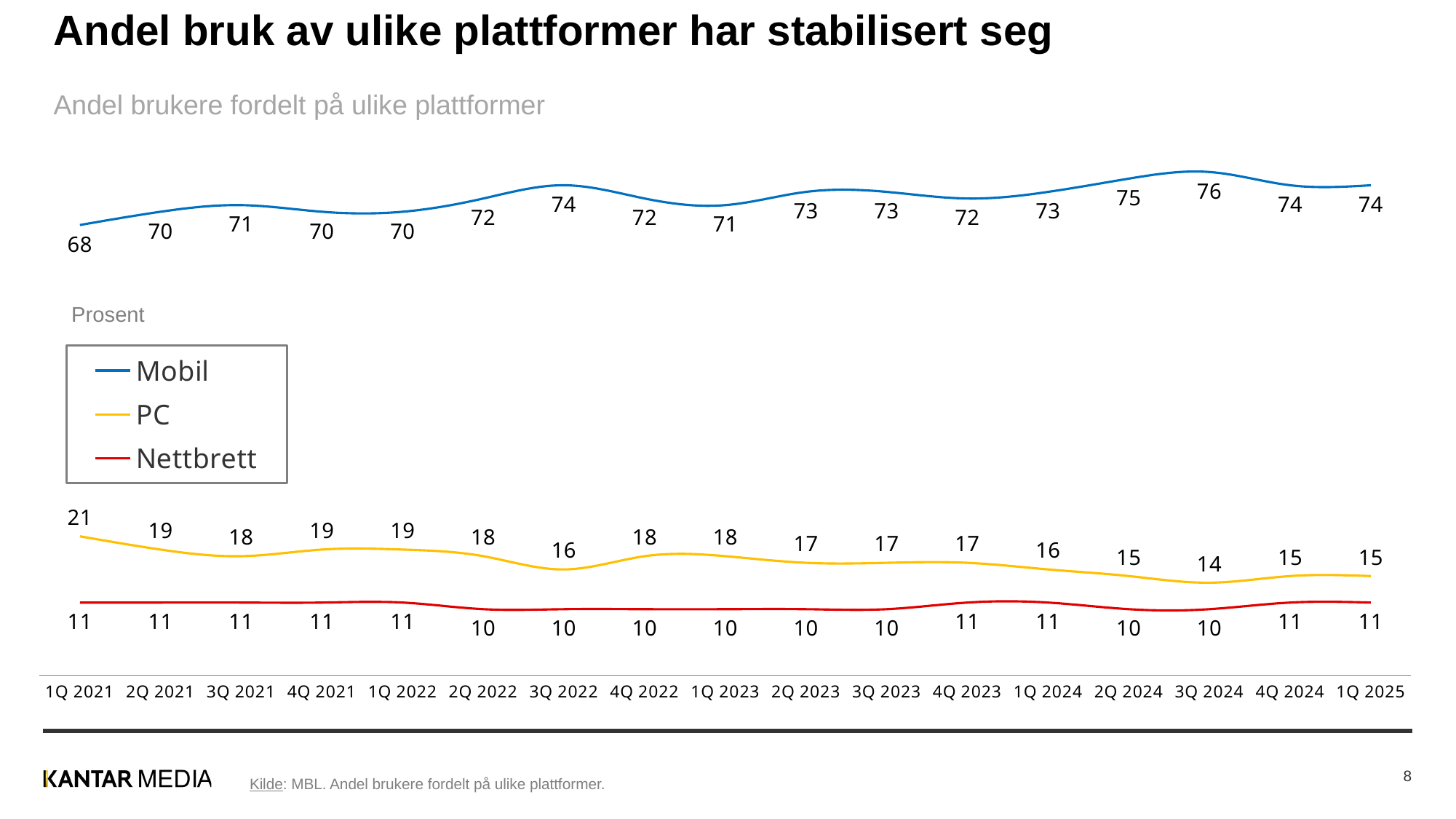
What kind of chart is shown on the slide? line chart What is the difference between the Mobil value and the PC value in 1Q 2025? 59 How many series does the legend list? 3 What is the value for Nettbrett in 1Q 2025? 11 Does the PC series rise or fall overall from 1Q 2021 to 1Q 2025? fall In which quarter does PC have its lowest value? 3Q 2024 In which quarter does Mobil reach its highest value? 3Q 2024 What is the value for Mobil in 1Q 2021? 68 How many quarters are plotted along the x axis? 17 Which series has the higher value in 2Q 2023, PC or Nettbrett? PC Which colour is used for the Nettbrett line? red What is the value for PC in 3Q 2022? 16